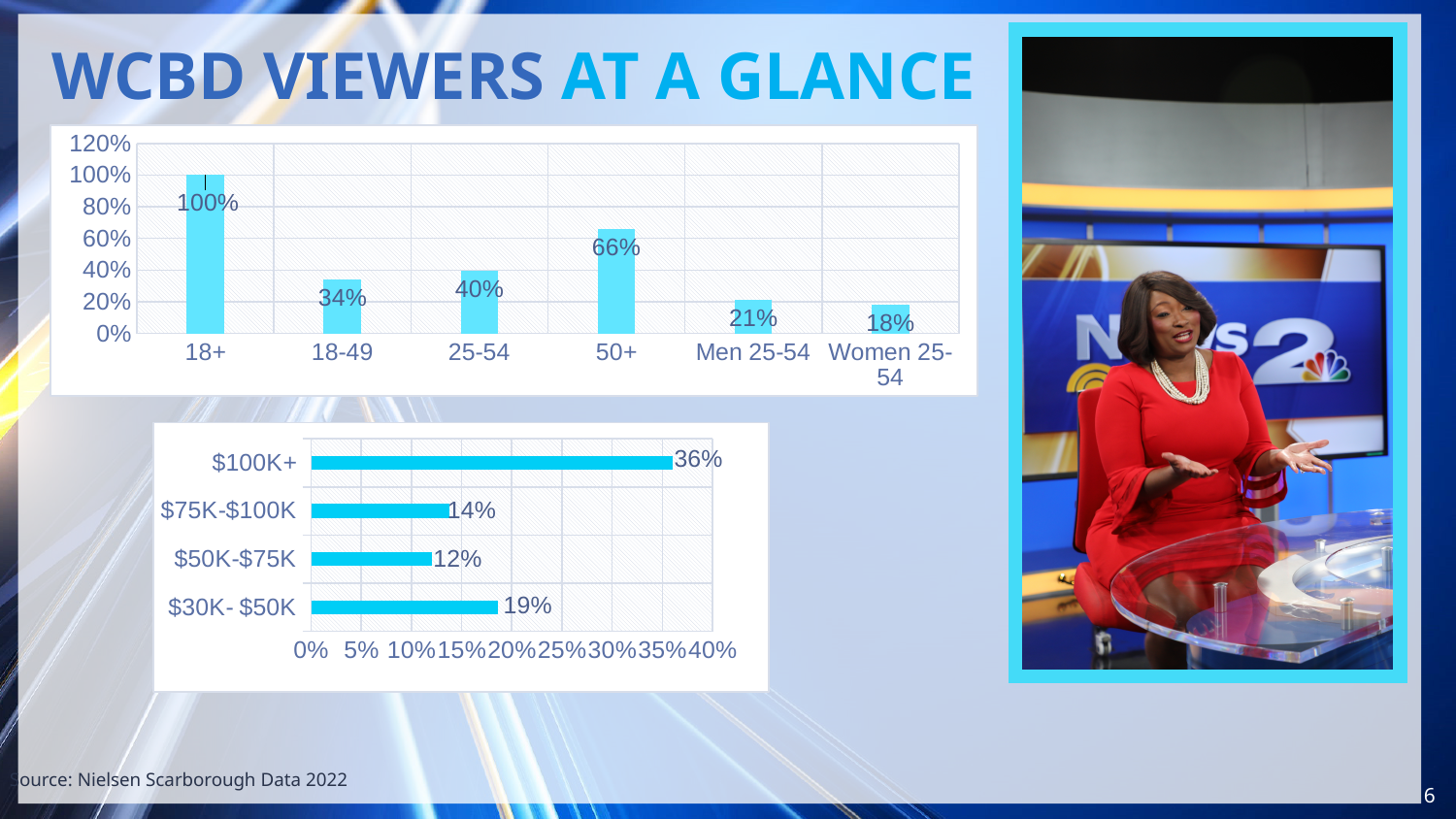
How many categories are shown in the bottom chart? 4 In the top chart, what is the difference between the values for 25-54 and 18-49? 6% In the bottom chart, which is larger, the value for $75K-$100K or the value for $30K-$50K? $30K-$50K In the top chart, which is larger, the value for 18-49 or the value for Men 25-54? 18-49 In the bottom chart, what is the value for $50K-$75K? 12% In the bottom chart, what is the difference between the values for $100K+ and $30K-$50K? 17% In the top chart, which category has the lowest value? Women 25-54 In the top chart, what is the value for Women 25-54? 18% How many categories are shown in the top chart? 6 In the bottom chart, which income category has the highest value? $100K+ What type of chart is the bottom chart? Bar chart In the top chart, what is the value for 50+? 66%